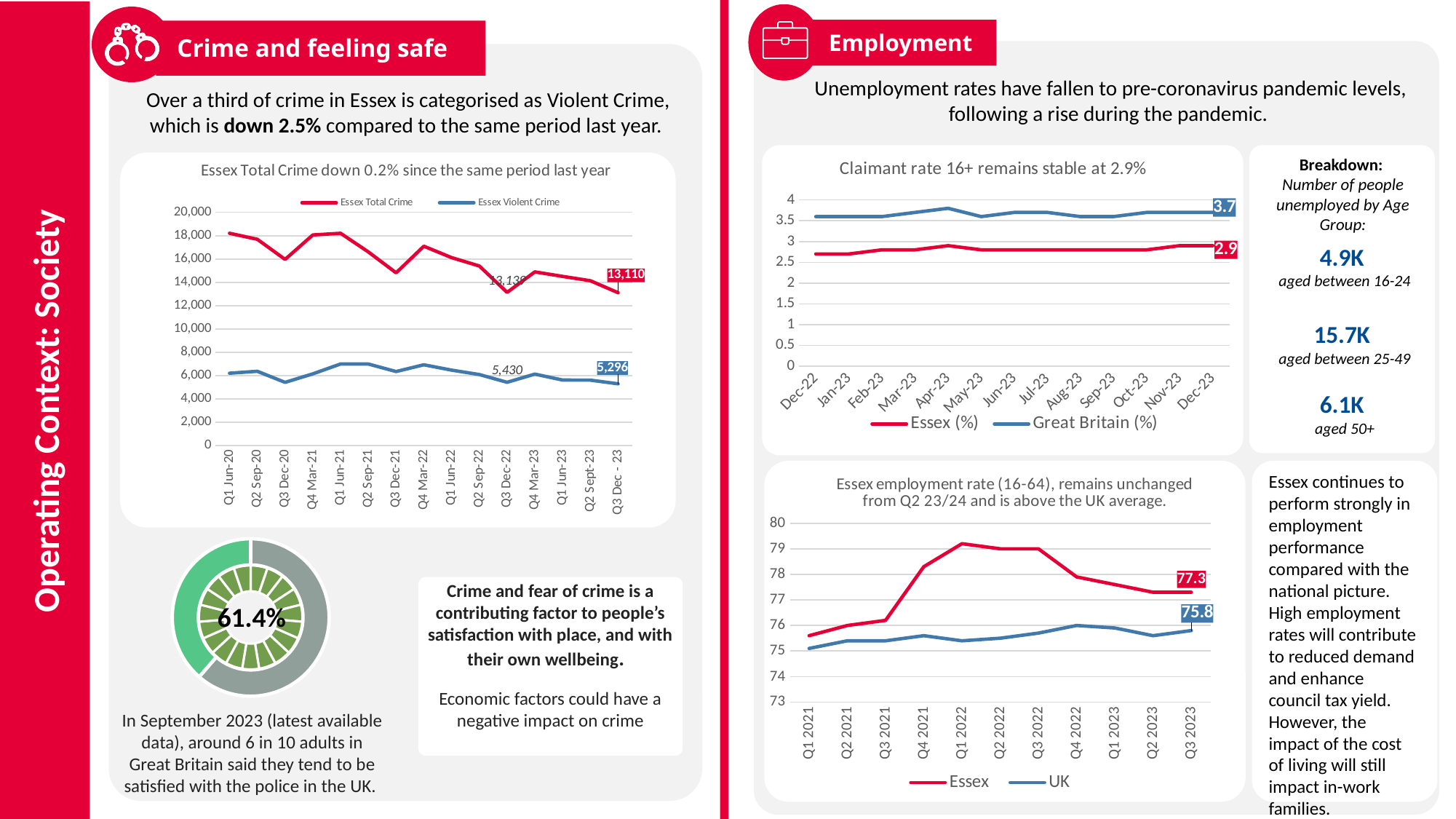
What kind of chart is the 'Essex employment rate (16-64)' chart? Line chart In the 'Essex Total Crime' chart, what is the difference between Essex Violent Crime at Q3 Dec-22 and at Q3 Dec - 23? 134 In the 'Essex Total Crime' chart, how many series does the legend list? 2 In the 'Claimant rate 16+' chart, what is the value for Essex (%) at Dec-23? 2.9 In the 'Essex employment rate (16-64)' chart, which series is higher at Q3 2023, Essex or UK? Essex In the 'Essex Total Crime' chart, what is the value of Essex Violent Crime at Q3 Dec - 23? 5,296 In the 'Claimant rate 16+' chart, how many months are shown on the x axis? 13 In the 'Essex employment rate (16-64)' chart, what is the value for Essex at Q3 2023? 77.3 In the 'Essex Total Crime' chart, what is the value of Essex Violent Crime at Q3 Dec-22? 5,430 In the 'Essex Total Crime' chart, is the value of Essex Total Crime at Q1 Jun-20 greater or less than 16,000? greater In the 'Essex Total Crime' chart, what is the value of Essex Total Crime at Q3 Dec - 23? 13,110 In the 'Claimant rate 16+' chart, what is the value for Great Britain (%) at Dec-23? 3.7